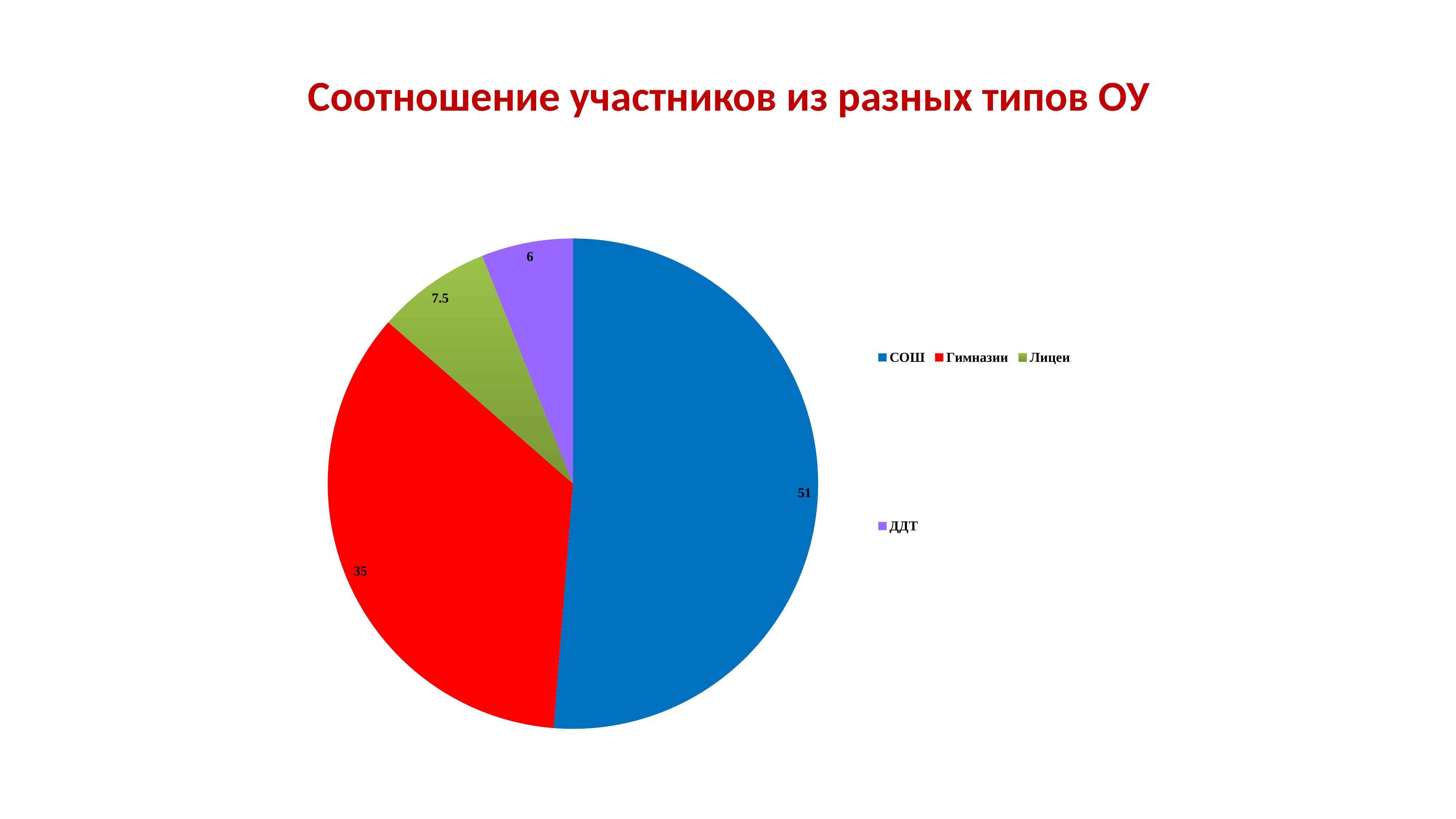
Which category has the smallest slice? ДДТ What is the value for СОШ? 51 What is the value for ДДТ? 6 How many categories does the pie chart have? 4 Which is larger, the value for Гимназии or the value for Лицеи? Гимназии What is the value for Лицеи? 7.5 What is the title of the chart? Соотношение участников из разных типов ОУ What is the value for Гимназии? 35 What is the difference between the values for СОШ and Гимназии? 16 What kind of chart is shown on the slide? pie chart What is the difference between the values for Лицеи and ДДТ? 1.5 Which category has the largest slice? СОШ